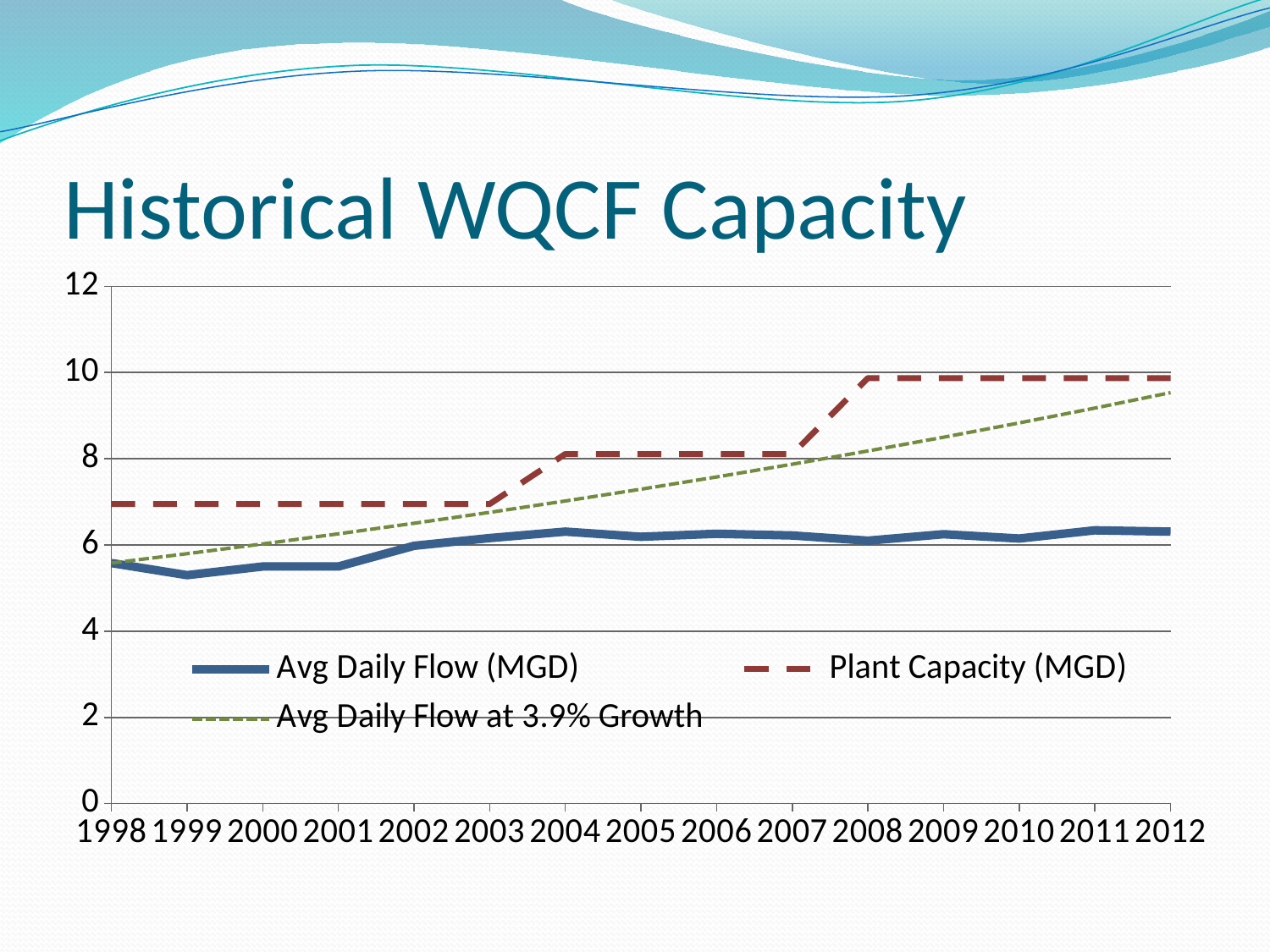
In 2012, which is larger: Plant Capacity (MGD) or Avg Daily Flow (MGD)? Plant Capacity (MGD) Is the value for Plant Capacity (MGD) in 2010 greater or less than 8? greater Which series is drawn with a dashed red line? Plant Capacity (MGD) Is the value for Plant Capacity (MGD) in 2000 greater or less than 8? less Is the value for Avg Daily Flow (MGD) in 1999 greater or less than 6? less How many series does the legend list? 3 How many years are shown along the x axis? 15 Does the Avg Daily Flow at 3.9% Growth line rise or fall from 1998 to 2012? Rise In 2006, which is larger: Avg Daily Flow at 3.9% Growth or Avg Daily Flow (MGD)? Avg Daily Flow at 3.9% Growth What kind of chart is shown on the slide? Line chart What is the title of the chart? Historical WQCF Capacity